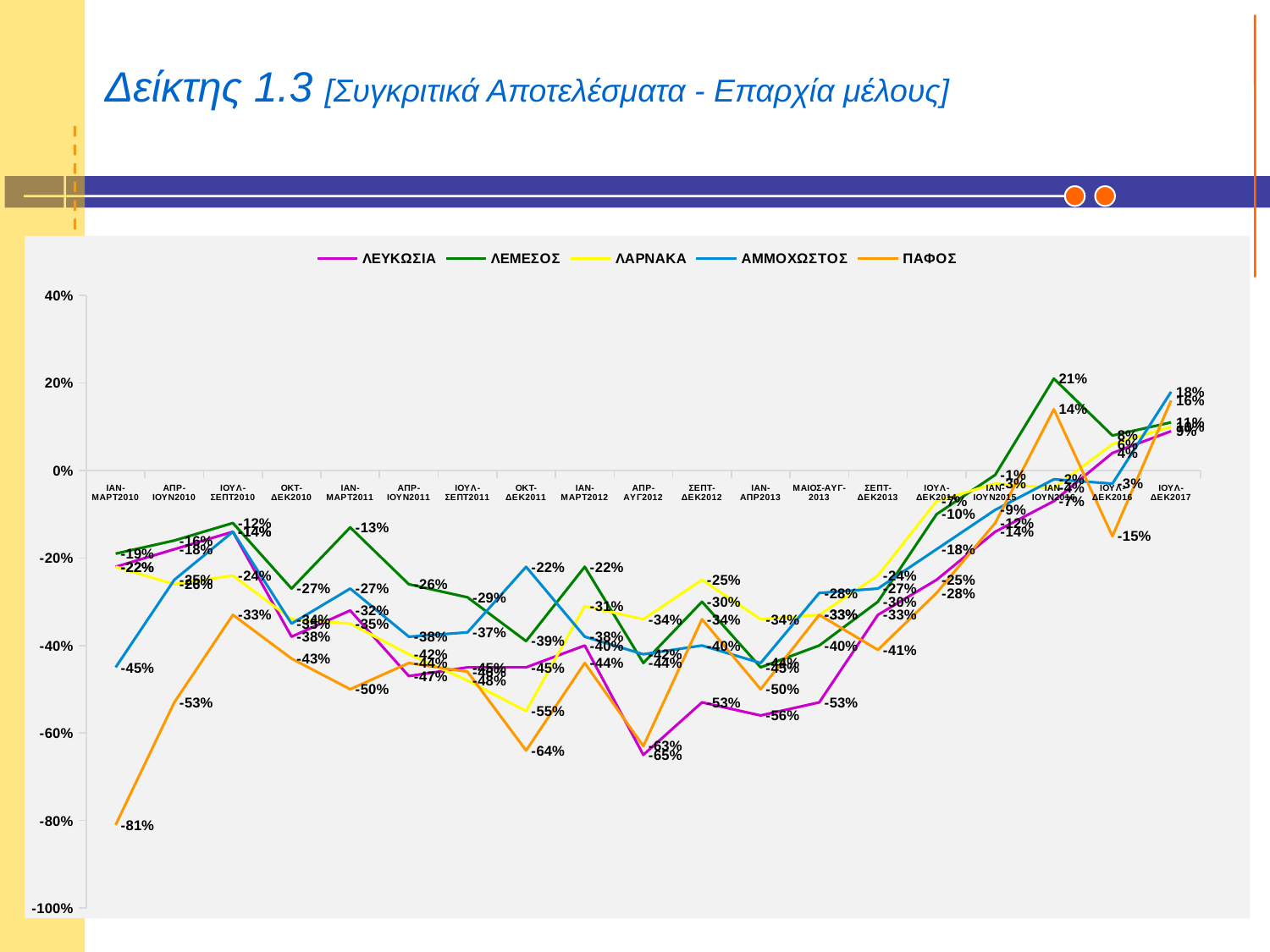
What is the difference between the ΑΜΜΟΧΩΣΤΟΣ and ΠΑΦΟΣ values in ΙΑΝ-ΜΑΡΤ2010? 36 percentage points Does the ΠΑΦΟΣ line rise or fall from ΙΑΝ-ΜΑΡΤ2010 to ΑΠΡ-ΙΟΥΝ2010? rise What is the value for ΑΜΜΟΧΩΣΤΟΣ in ΙΑΝ-ΜΑΡΤ2010? -45% Is the value for ΛΕΥΚΩΣΙΑ in ΑΠΡ-ΑΥΓ2012 greater or less than -60%? less How many series does the legend list? 5 What is the value for ΠΑΦΟΣ in ΙΟΥΛ-ΔΕΚ2016? -15% Which is larger in ΟΚΤ-ΔΕΚ2011: the value for ΛΑΡΝΑΚΑ or the value for ΠΑΦΟΣ? ΛΑΡΝΑΚΑ Which series has the highest value in ΙΑΝ-ΙΟΥΝ2016? ΛΕΜΕΣΟΣ What is the value for ΛΕΜΕΣΟΣ in ΙΑΝ-ΙΟΥΝ2016? 21% Which series has the lowest value in ΙΑΝ-ΜΑΡΤ2010? ΠΑΦΟΣ What kind of chart is shown on the slide? line chart What is the value for ΠΑΦΟΣ in ΙΑΝ-ΜΑΡΤ2010? -81%